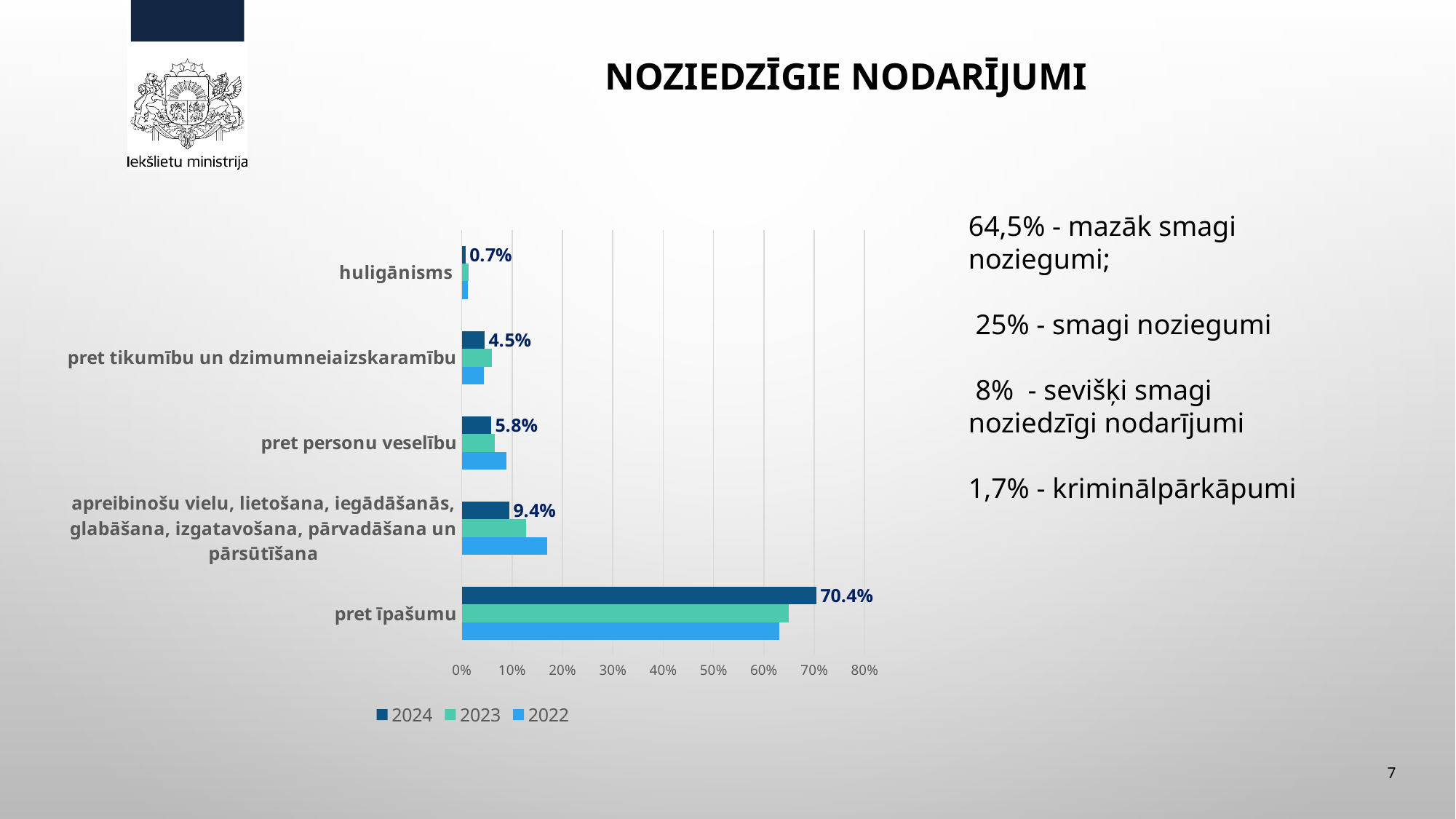
How many series does the chart legend list? 3 What kind of chart is shown on the slide? bar chart What is the 2024 value for 'pret tikumību un dzimumneiaizskaramību'? 4.5% What is the difference between the 2024 values for 'pret īpašumu' and 'pret personu veselību'? 64.6% Which category has the highest 2024 value? pret īpašumu Which series is shown in the darkest blue colour in the legend? 2024 Which category has the lowest 2024 value? huligānisms What is the 2024 value for 'pret īpašumu'? 70.4% Is the 2022 value for 'pret īpašumu' greater or less than 60%? greater How many categories are shown on the chart? 5 What is the 2024 value for 'huligānisms'? 0.7% What is the 2024 value for 'pret personu veselību'? 5.8%